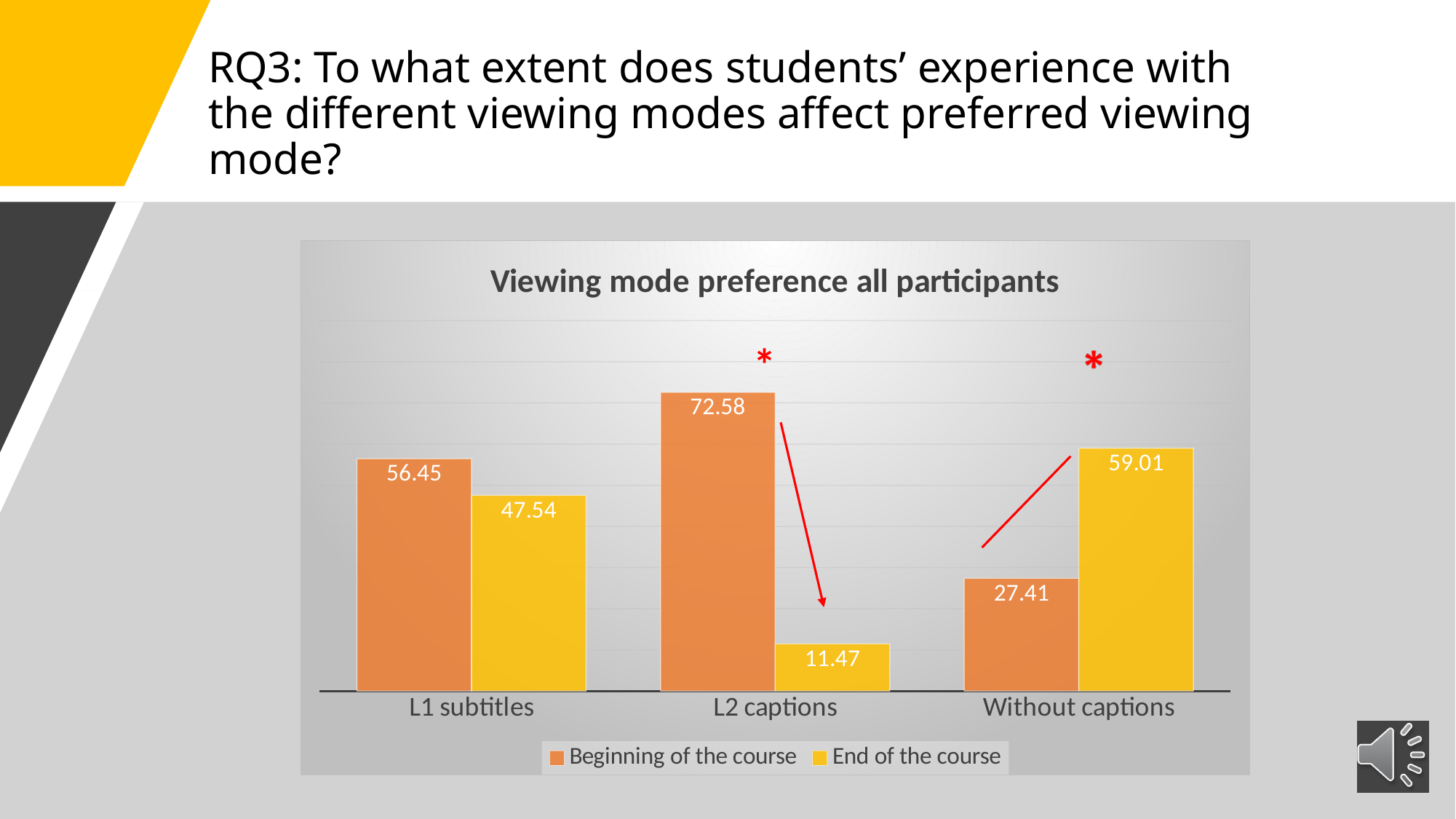
Which viewing mode has the highest value at the beginning of the course? L2 captions Which is larger for L1 subtitles: the beginning of the course value or the end of the course value? Beginning of the course How many series does the legend list? 2 What is the difference between the end and beginning of the course values for Without captions? 31.6 What is the value for L2 captions at the beginning of the course? 72.58 Which viewing mode has the lowest value at the end of the course? L2 captions What is the value for L1 subtitles at the end of the course? 47.54 What is the difference between the beginning and end of the course values for L2 captions? 61.11 What is the title of the chart? Viewing mode preference all participants How many viewing mode categories are shown on the x axis? 3 What kind of chart is shown on the slide? Bar chart What is the value for Without captions at the end of the course? 59.01